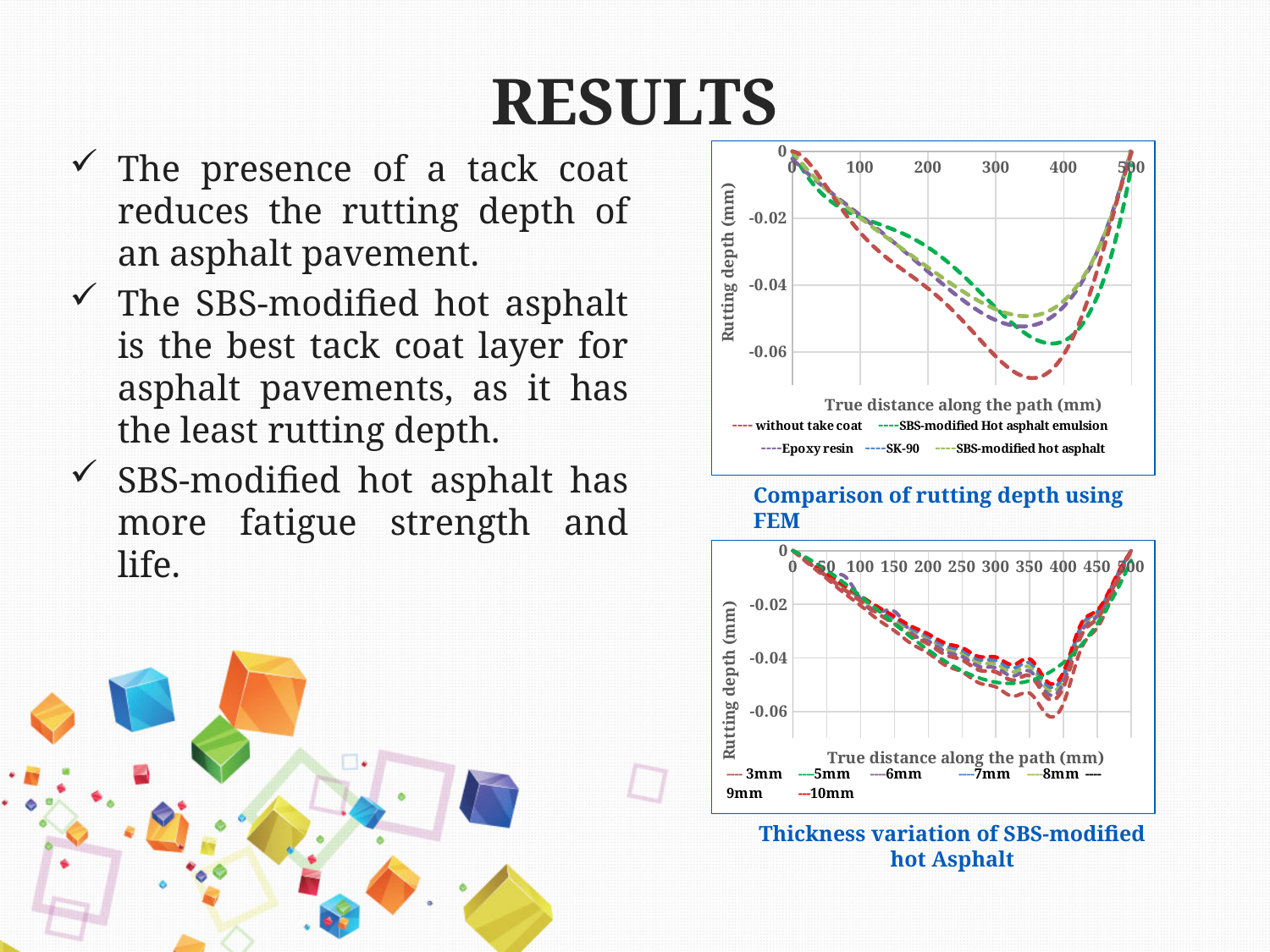
In the 'Comparison of rutting depth using FEM' chart, do the values rise or fall along the x axis between 0 and 300 mm? fall How many series does the legend of the 'Comparison of rutting depth using FEM' chart list? 5 What is the x-axis title of the 'Thickness variation of SBS-modified hot Asphalt' chart? True distance along the path (mm) What is the y-axis title of the 'Comparison of rutting depth using FEM' chart? Rutting depth (mm) In the 'Thickness variation of SBS-modified hot Asphalt' chart, do the values rise or fall along the x axis between 400 and 500 mm? rise How many series does the legend of the 'Thickness variation of SBS-modified hot Asphalt' chart list? 7 In the 'Comparison of rutting depth using FEM' chart, is the lowest value for 'Epoxy resin' greater or less than -0.06? greater In the 'Comparison of rutting depth using FEM' chart, which series reaches the lowest (deepest) rutting depth? without take coat What kind of chart is the 'Comparison of rutting depth using FEM' chart? line chart In the 'Comparison of rutting depth using FEM' chart, is the lowest value for 'without take coat' greater or less than -0.06? less What kind of chart is the 'Thickness variation of SBS-modified hot Asphalt' chart? line chart In the 'Comparison of rutting depth using FEM' chart, what is the largest value shown on the x axis? 500